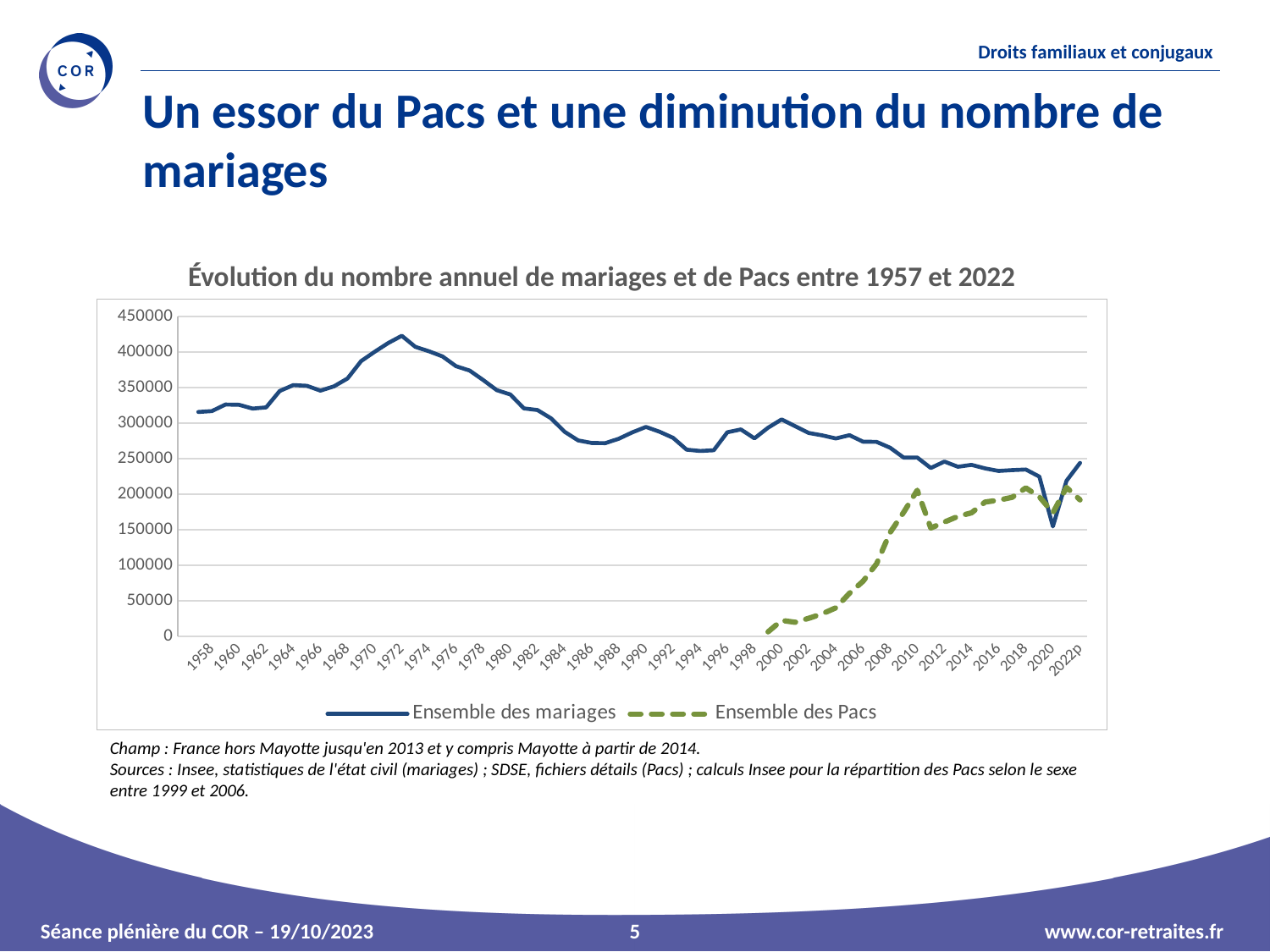
Does the 'Ensemble des mariages' series rise or fall between 1972 and 1986? fall In 2000, which series has the larger value, 'Ensemble des mariages' or 'Ensemble des Pacs'? Ensemble des mariages What kind of chart is shown on the slide? line chart In which year does the 'Ensemble des mariages' series reach its lowest value? 2020 Is the value for 'Ensemble des mariages' in 1972 greater or less than 400000? greater In which year does the 'Ensemble des mariages' series reach its highest value? 1972 How many series does the chart legend list? 2 Which series is drawn with a dashed line? Ensemble des Pacs Is the value for 'Ensemble des Pacs' in 2000 greater or less than 50000? less Is the value for 'Ensemble des Pacs' in 2010 greater or less than 150000? greater What is the title of the chart? Évolution du nombre annuel de mariages et de Pacs entre 1957 et 2022